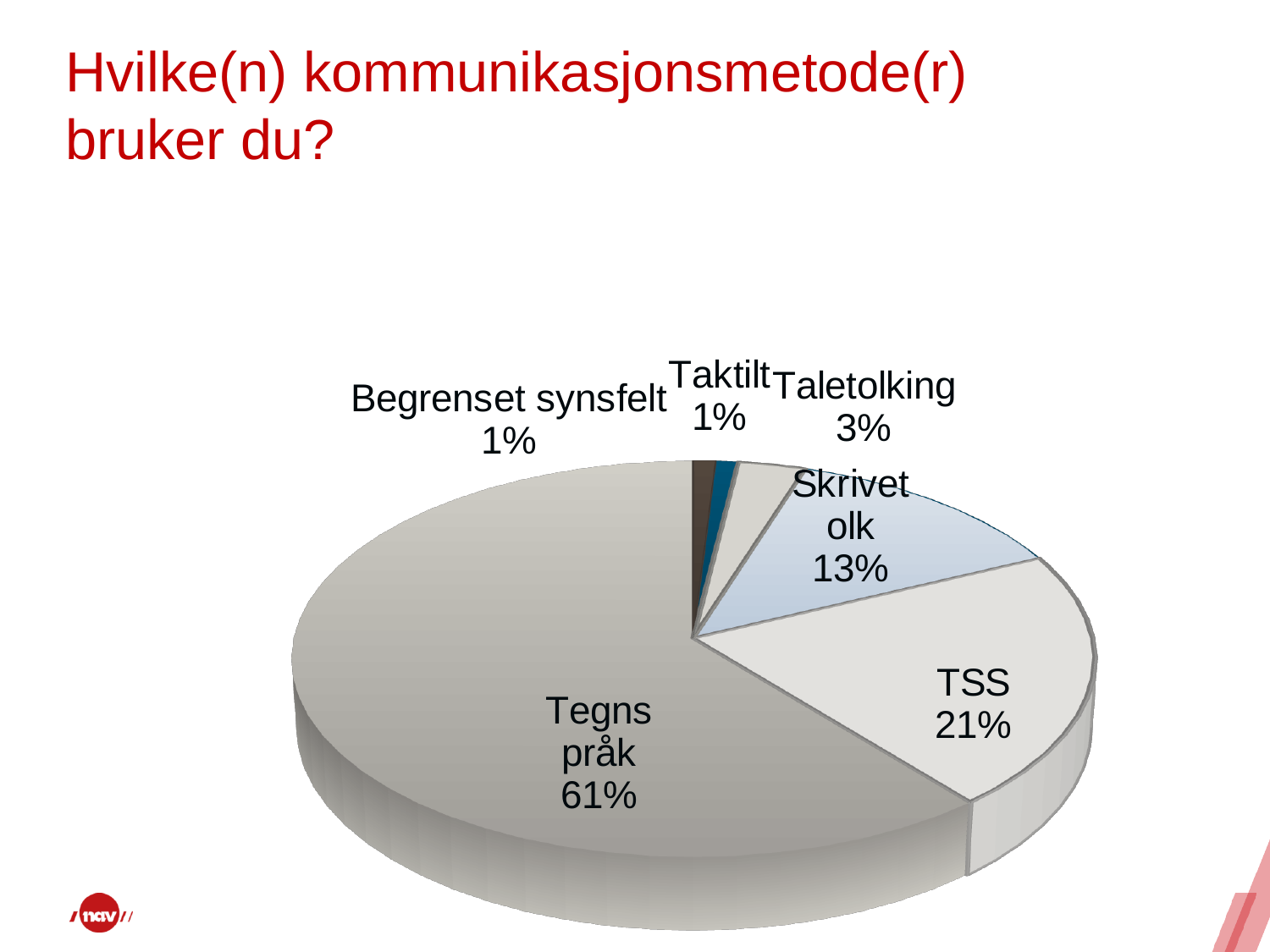
What is the value shown for Taletolking? 3% What is the value shown for Begrenset synsfelt? 1% What is the value shown for Skrivetolk? 13% What is the title of the slide containing the chart? Hvilke(n) kommunikasjonsmetode(r) bruker du? What share of the pie does Tegnspråk have? 61% What is the difference between the shares of Tegnspråk and TSS? 40% Which is larger, the share for Taletolking or the share for Taktilt? Taletolking Which category has the largest slice of the pie? Tegnspråk What kind of chart is shown on the slide? Pie chart How many slices does the pie chart have? 6 What is the value shown for TSS? 21% What is the difference between the shares of TSS and Skrivetolk? 8%